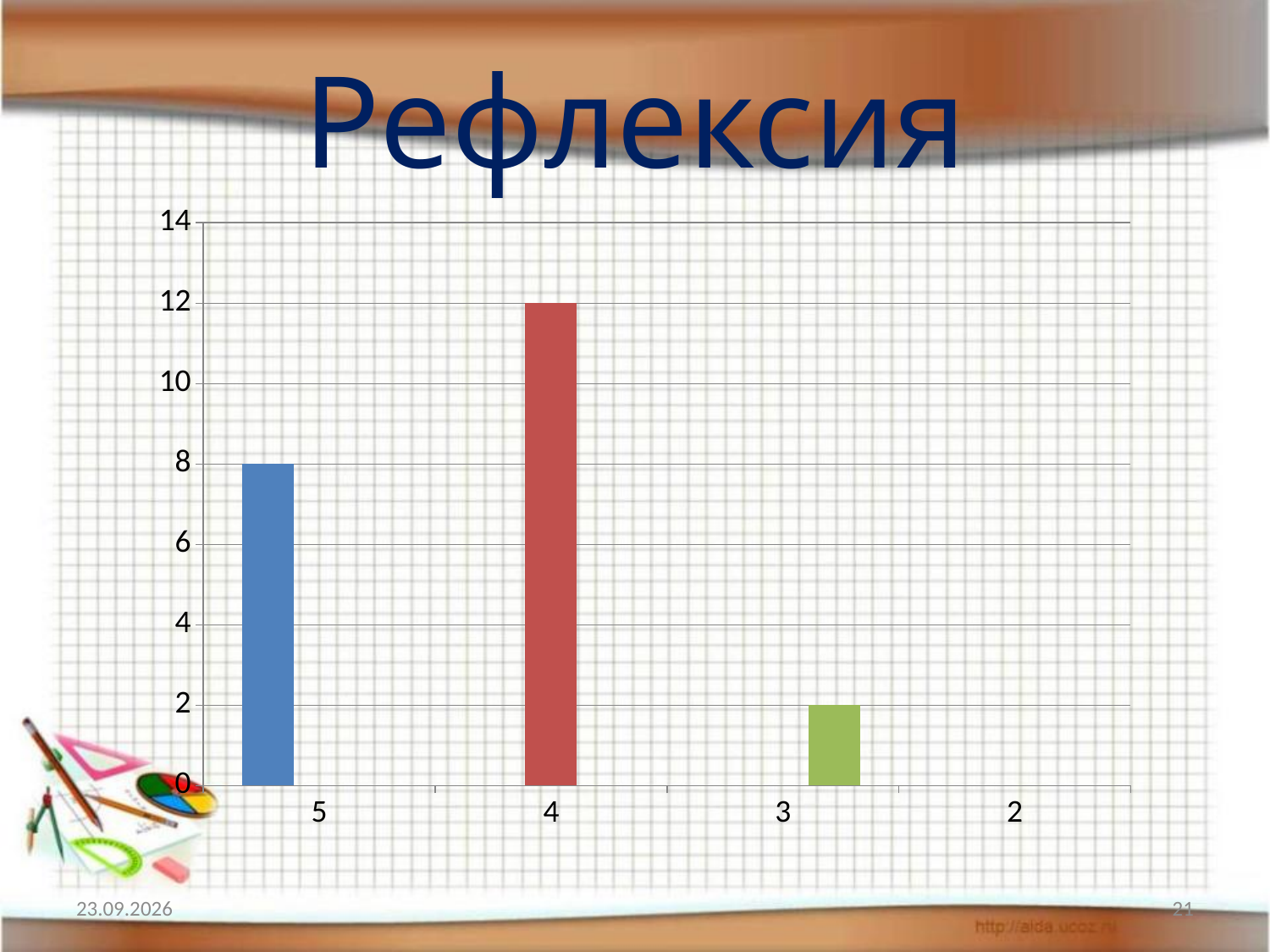
How many category labels are shown on the x axis? 4 What is the value of the bar for category 4? 12 What is the value of the bar for category 3? 2 What colour is the bar for category 4? red What is the difference between the values for category 4 and category 5? 4 Which is larger, the bar for category 5 or the bar for category 3? 5 What is the title of the slide with the chart? Рефлексия Which category has the highest bar? 4 What kind of chart is shown on the slide? bar chart Which category with a visible bar has the lowest value? 3 What is the value of the bar for category 5? 8 What is the difference between the values for category 5 and category 3? 6